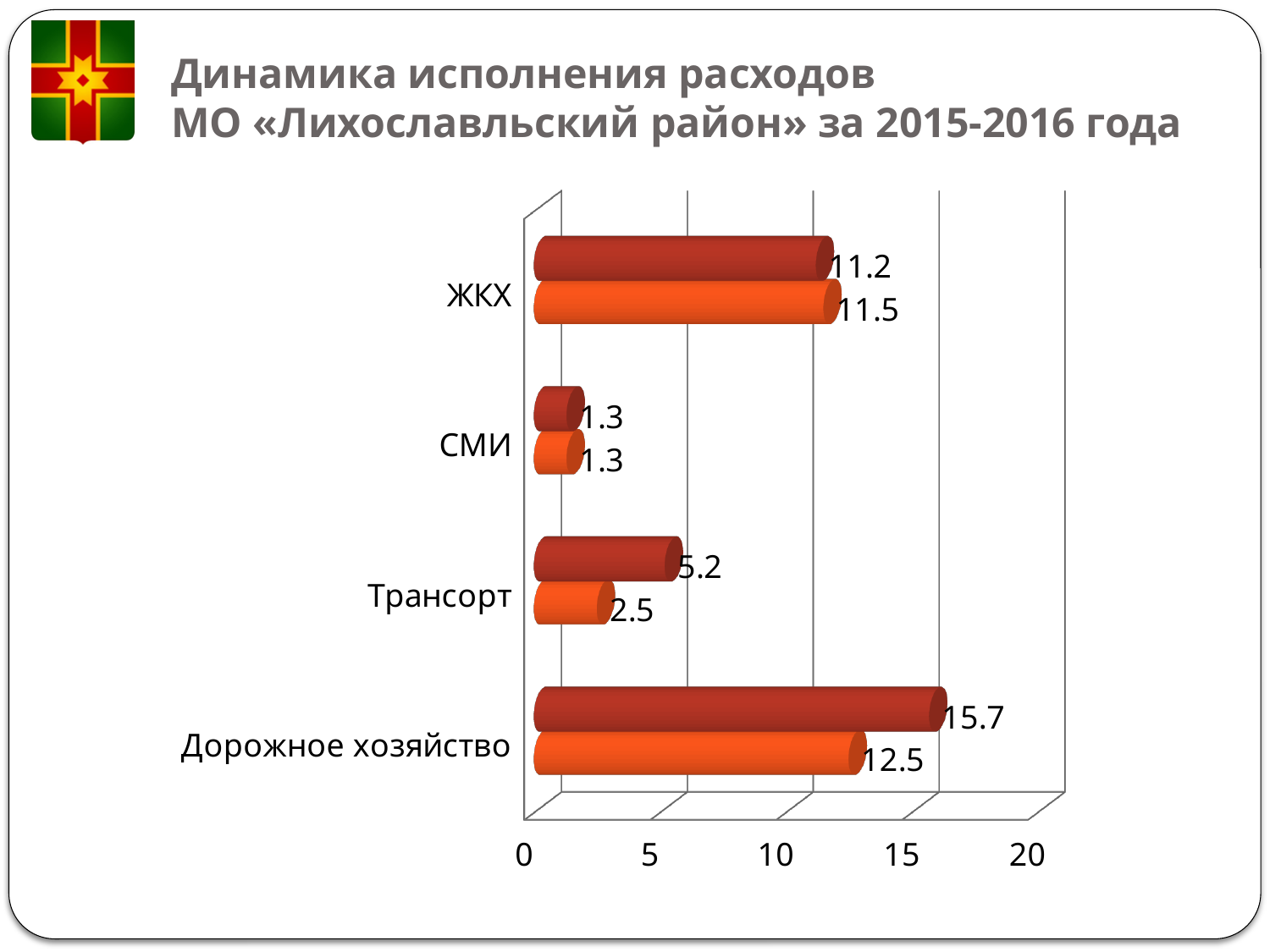
What kind of chart is shown on the slide? bar chart What is the value of the orange bar for ЖКХ? 11.5 For ЖКХ, which bar is larger, the dark red or the orange one? orange What is the value of the dark red bar for Дорожное хозяйство? 15.7 How many categories are shown on the chart? 4 What is the difference between the dark red and orange bar values for Трансорт? 2.7 What is the value of the dark red bar for СМИ? 1.3 What is the value of the orange bar for Трансорт? 2.5 What is the difference between the dark red and orange bar values for Дорожное хозяйство? 3.2 Which category has the lowest orange bar value? СМИ Is the dark red bar value for Дорожное хозяйство greater or less than 15? greater Which category has the highest dark red bar value? Дорожное хозяйство